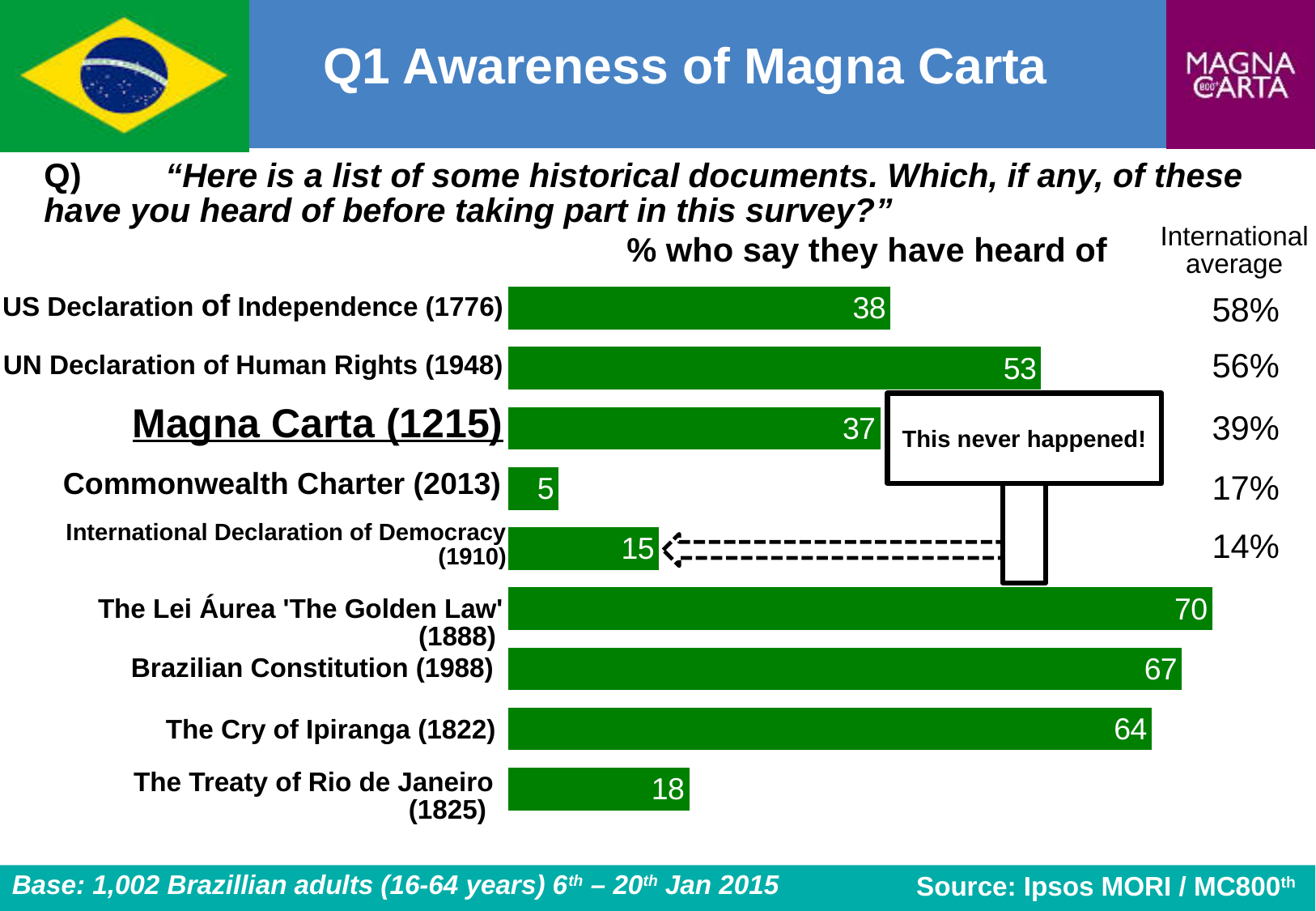
What is the difference between the values for the Brazilian Constitution (1988) and the Cry of Ipiranga (1822)? 3 What kind of chart is shown on the slide? Bar chart What is the value shown for the UN Declaration of Human Rights (1948)? 53 What is the international average shown for the Magna Carta (1215)? 39% Which document has the highest percentage of people who say they have heard of it? The Lei Áurea 'The Golden Law' (1888) Which has a higher value: the US Declaration of Independence (1776) or the Magna Carta (1215)? US Declaration of Independence (1776) What percentage of Brazilian adults say they have heard of the Magna Carta (1215)? 37 How many documents are listed in the chart? 9 What is the value shown for the Treaty of Rio de Janeiro (1825)? 18 Which document has the lowest percentage of people who say they have heard of it? Commonwealth Charter (2013) What does the callout box on the chart say? This never happened! What is the difference between the values for the International Declaration of Democracy (1910) and the Commonwealth Charter (2013)? 10